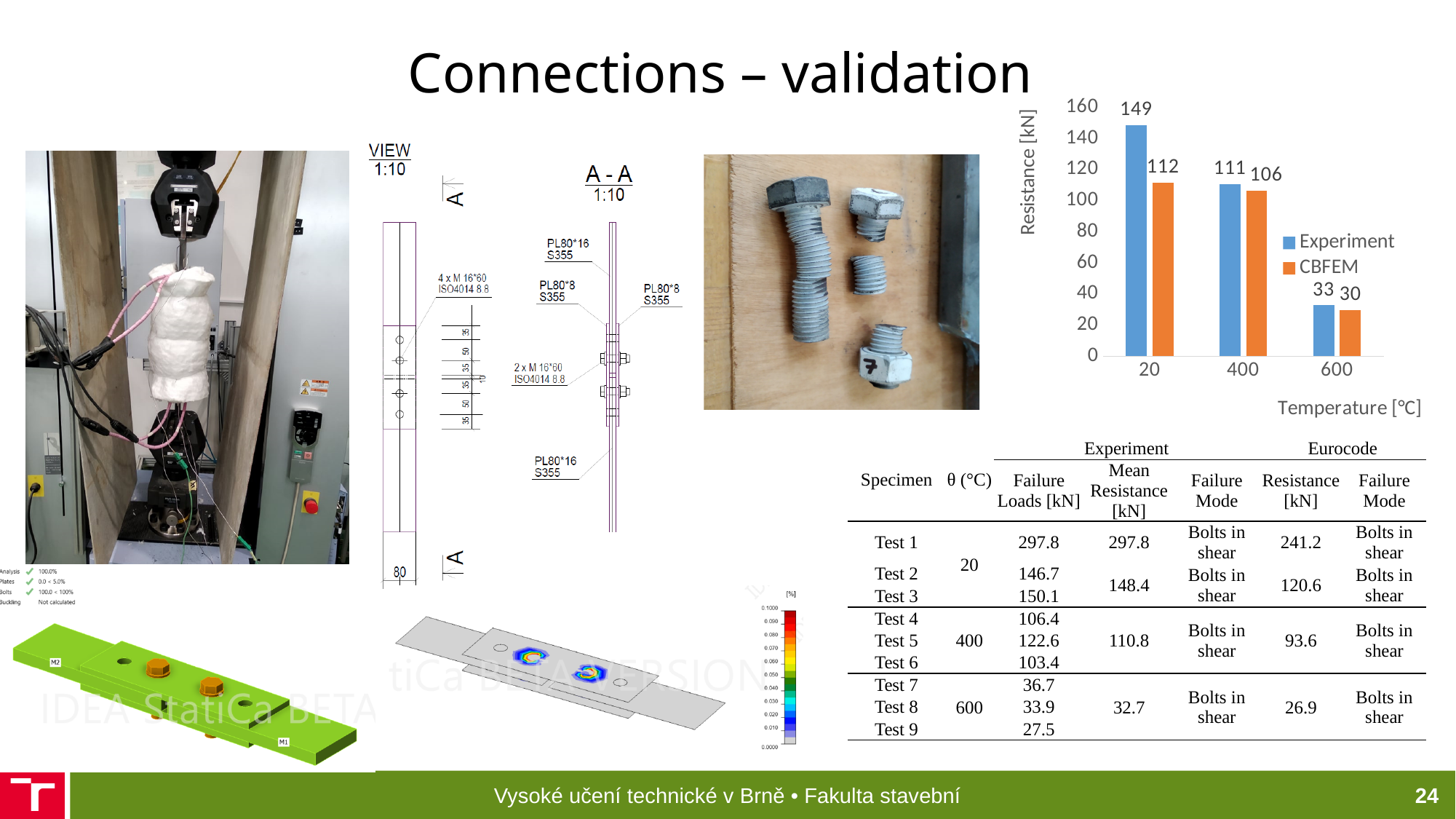
What is the CBFEM resistance at 400 °C? 106 How many temperature categories are shown on the x axis of the bar chart? 3 What is the Experiment resistance at 20 °C? 149 What is the CBFEM resistance at 600 °C? 30 What is the difference between the Experiment resistance at 400 °C and at 600 °C? 78 Do the Experiment resistance values rise or fall as temperature increases? fall What kind of chart shows Resistance [kN] against Temperature [°C]? bar chart At which temperature is the CBFEM resistance lowest? 600 Which is larger at 400 °C, the Experiment or the CBFEM resistance? Experiment At which temperature is the Experiment resistance highest? 20 How many series does the legend of the bar chart list? 2 What is the difference between the Experiment and CBFEM resistance at 20 °C? 37